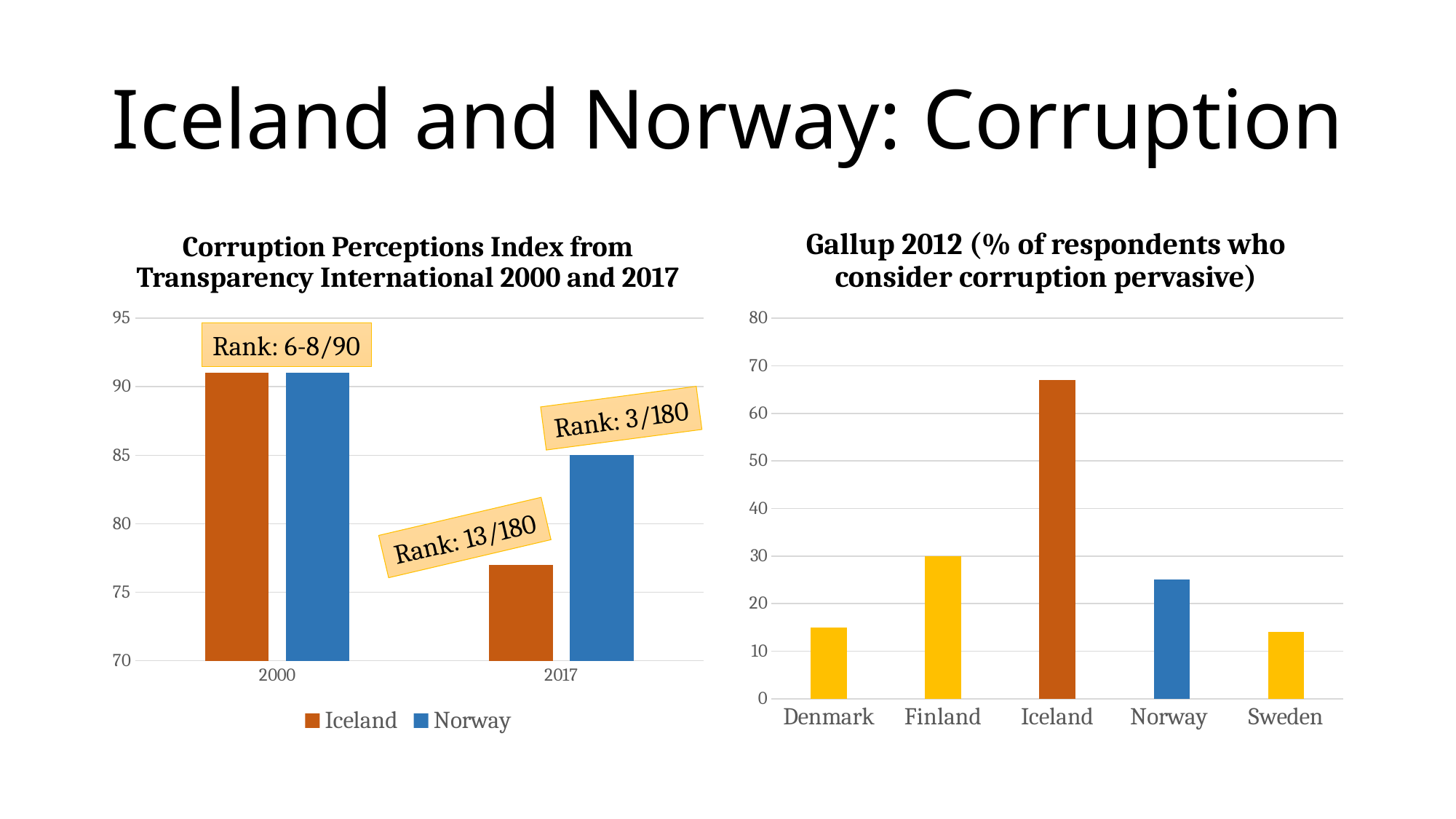
In the Gallup 2012 chart, is the value for Denmark greater or less than 20? less In the Corruption Perceptions Index chart, is the value for Iceland in 2017 greater or less than 80? less In the Corruption Perceptions Index chart, which series has the larger value in 2017, Iceland or Norway? Norway In the Gallup 2012 chart, which country has the larger value, Finland or Norway? Finland What kind of chart is the Corruption Perceptions Index chart on the left? bar chart In the Corruption Perceptions Index chart, is the value for Norway in 2000 greater or less than 90? greater How many series does the legend of the Corruption Perceptions Index chart list? 2 In the Gallup 2012 chart, which country has the highest value? Iceland In the Corruption Perceptions Index chart, what rank label is shown above the 2017 Norway bar? Rank: 3/180 How many countries are shown on the x axis of the Gallup 2012 chart? 5 In the Corruption Perceptions Index chart, does Iceland's value rise or fall from 2000 to 2017? fall